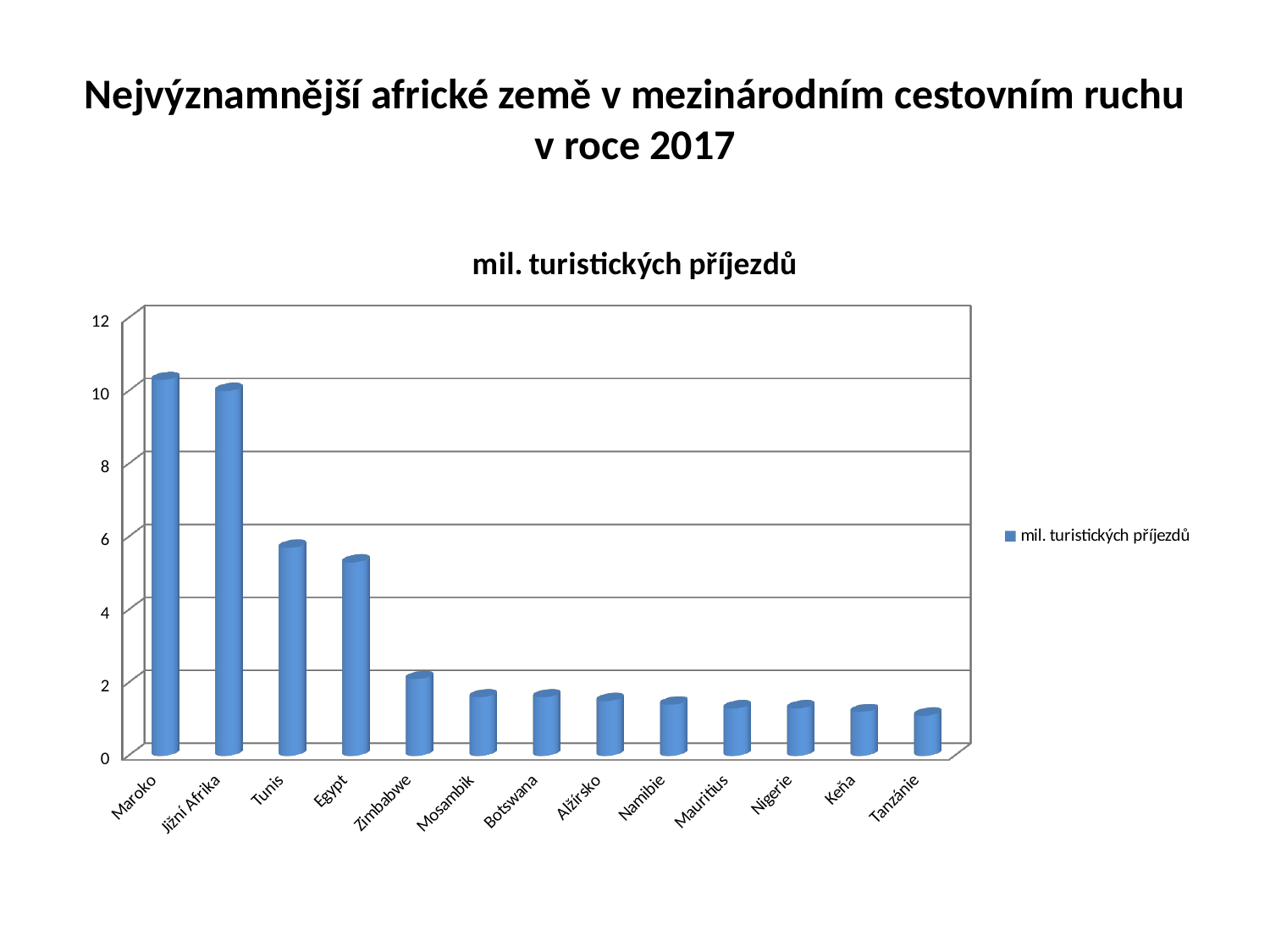
What kind of chart is shown on the slide? bar chart Is the value for Mosambik greater or less than 2? less Do the values rise or fall moving from left to right along the x axis? fall What is the title of the chart? mil. turistických příjezdů How many countries are shown on the x axis of the chart? 13 How many series does the legend list? 1 Which has the larger value, Tunis or Egypt? Tunis Is the value for Tunis greater or less than 4? greater Which country has the highest value in the chart? Maroko Is the value for Jižní Afrika greater or less than 8? greater